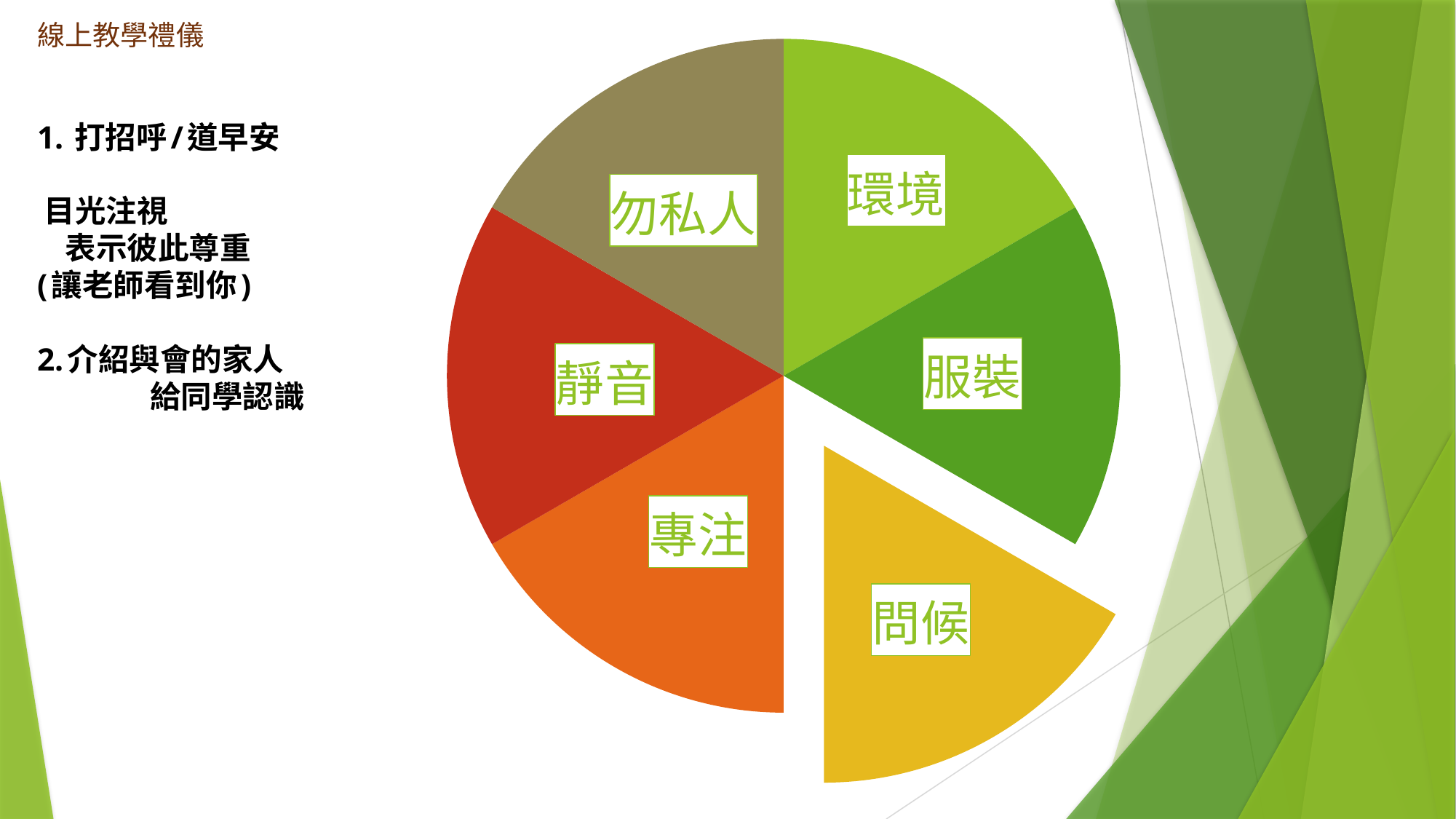
What colour is the 問候 slice of the pie chart? yellow Which slice of the pie chart is labelled in the dark green segment? 服裝 Which slice of the pie chart is labelled in the orange segment? 專注 How many slices does the pie chart have? 6 Which slice of the pie chart is labelled in the light green segment at the top right? 環境 What kind of chart is shown on the slide? pie chart Which slice of the pie chart is labelled in the red segment? 靜音 Which slice of the pie chart is pulled out (exploded) from the rest of the pie? 問候 Which slice of the pie chart is labelled in the grey-brown segment at the top left? 勿私人